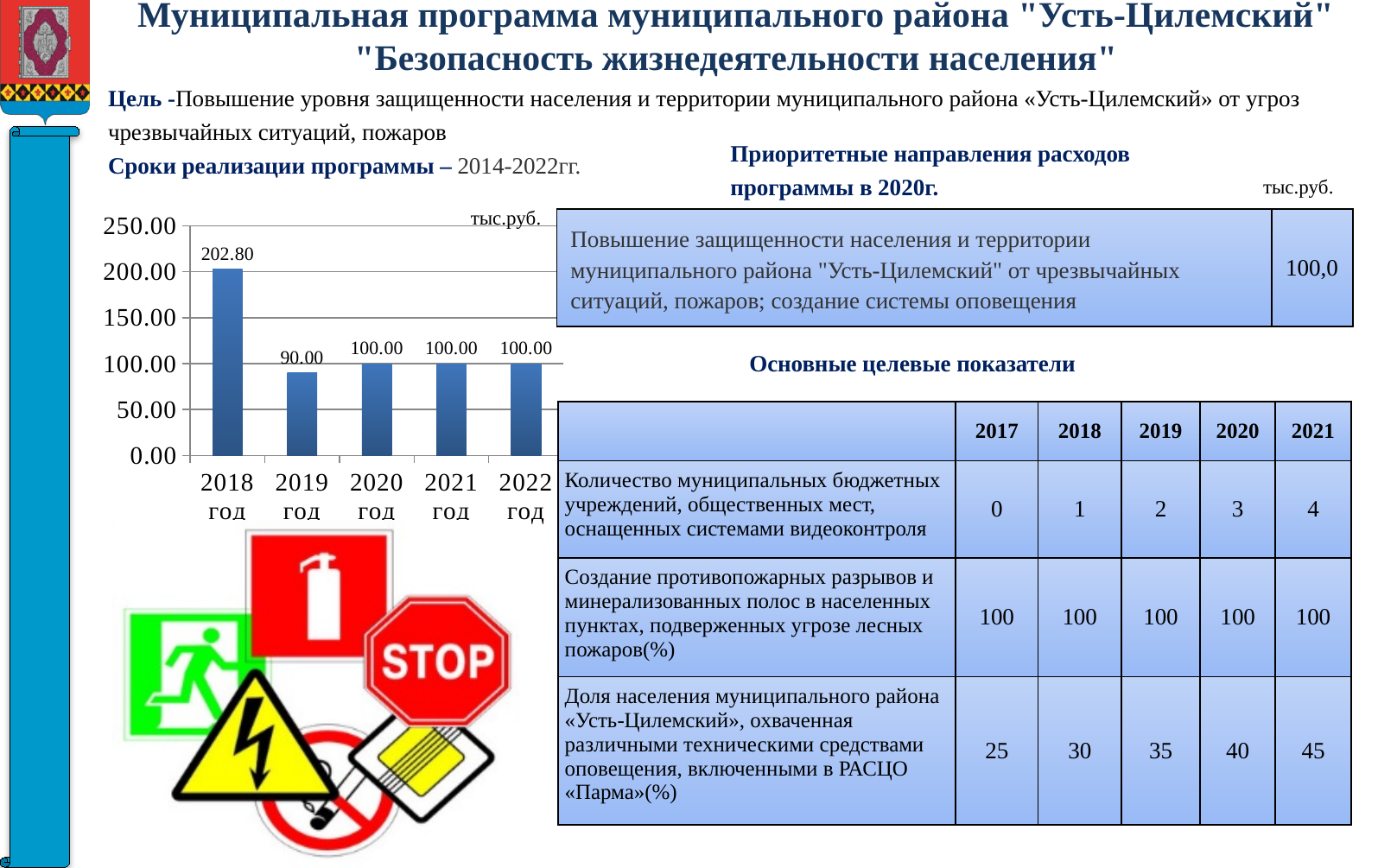
Is the value for 2018 год in the bar chart greater or less than 200.00? greater How many years are shown on the x axis of the bar chart? 5 What is the value for 2022 год in the bar chart? 100.00 Which year has the lowest value in the bar chart? 2019 год Which year has the highest value in the bar chart? 2018 год Which is larger in the bar chart, the value for 2018 год or the value for 2020 год? 2018 год What is the value for 2019 год in the bar chart? 90.00 What is the difference between the values for 2018 год and 2019 год in the bar chart? 112.80 What is the value for 2018 год in the bar chart? 202.80 What kind of chart is shown on the slide? bar chart What unit is indicated above the bar chart? тыс.руб. What is the difference between the values for 2020 год and 2019 год in the bar chart? 10.00